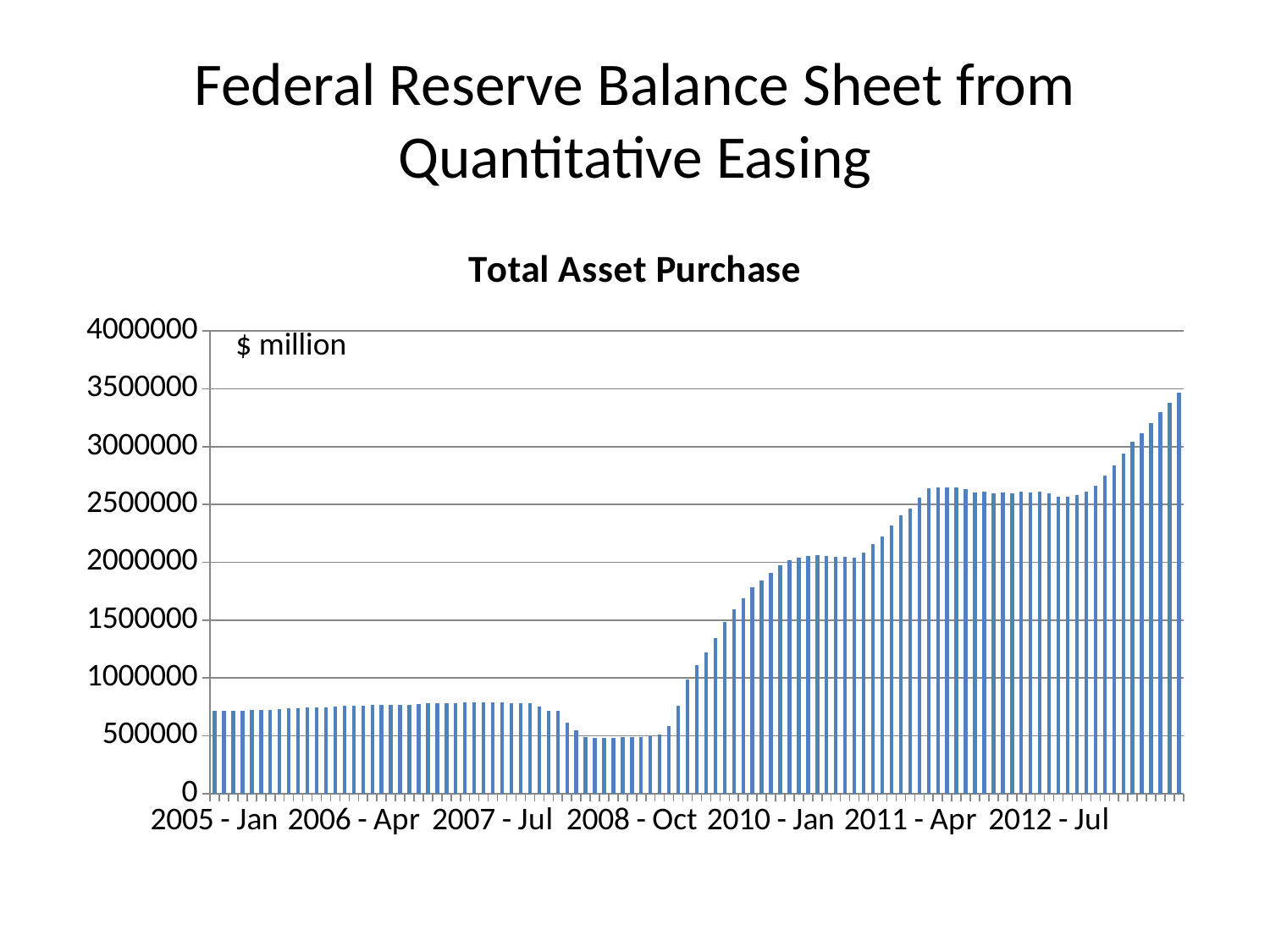
What is the title of the chart? Total Asset Purchase Which is larger, the value for 2012 - Jul or the value for 2005 - Jan? 2012 - Jul Is the value for 2011 - Apr greater or less than 2000000? greater Is the value for 2005 - Jan greater or less than 1000000? less Is the value for 2007 - Jul greater or less than 1000000? less Overall, do the values rise or fall from the left of the x axis to the right? rise What unit is indicated inside the plot area of the chart? $ million What kind of chart is shown on the slide? bar chart